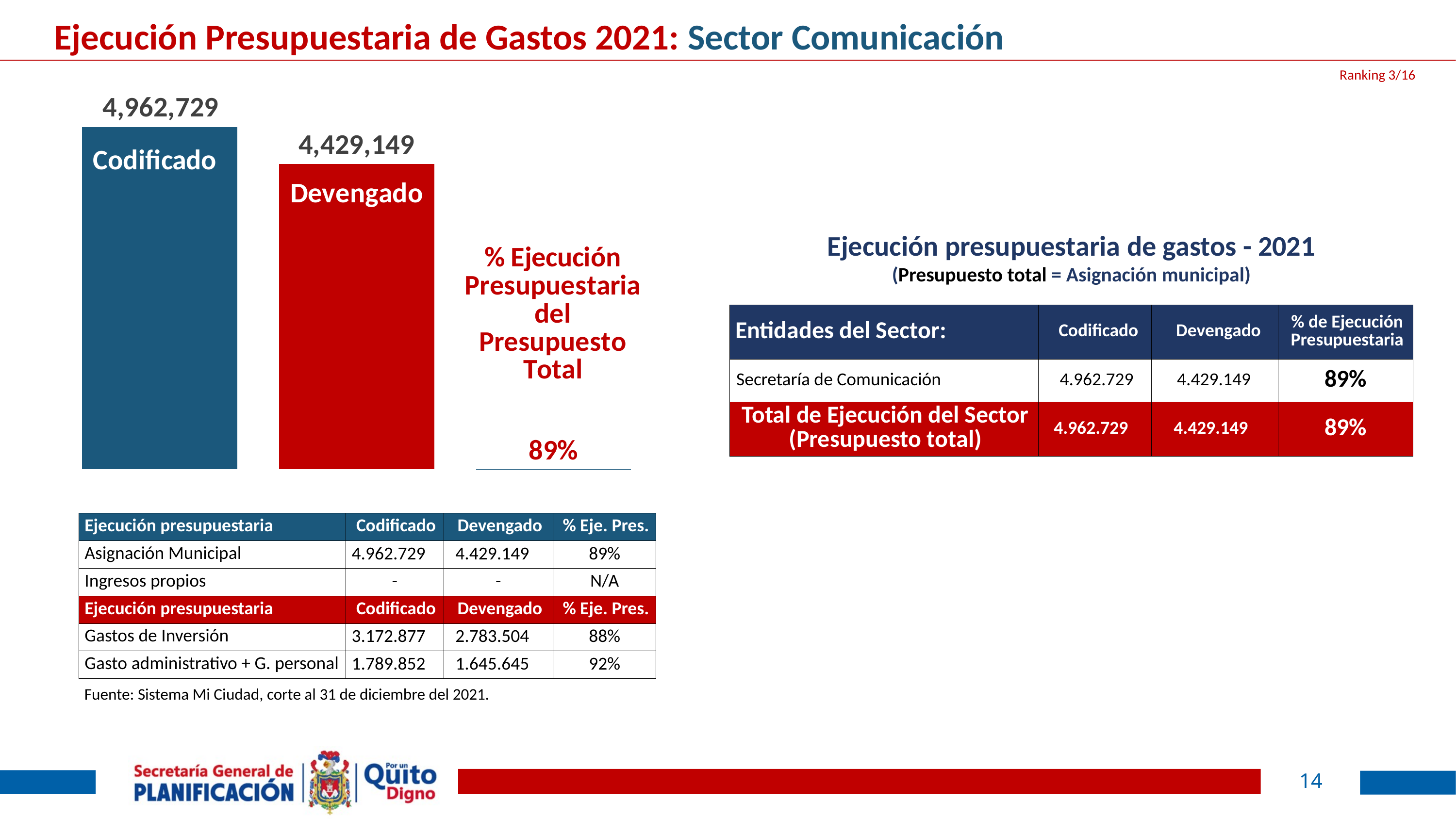
How many bars are plotted in the bar chart? 2 What type of chart is shown on the left of the slide? Bar chart What colour is the Codificado bar in the chart? Blue Which is larger in the bar chart, Codificado or Devengado? Codificado What is the value of the Devengado bar in the bar chart? 4,429,149 Which bar in the chart is the shortest? Devengado Which bar in the chart is the tallest? Codificado What is the value of the Codificado bar in the bar chart? 4,962,729 What percentage is shown next to the bar chart as the % Ejecución Presupuestaria del Presupuesto Total? 89% What is the difference between the Codificado and Devengado values in the bar chart? 533,580 What colour is the Devengado bar in the chart? Red